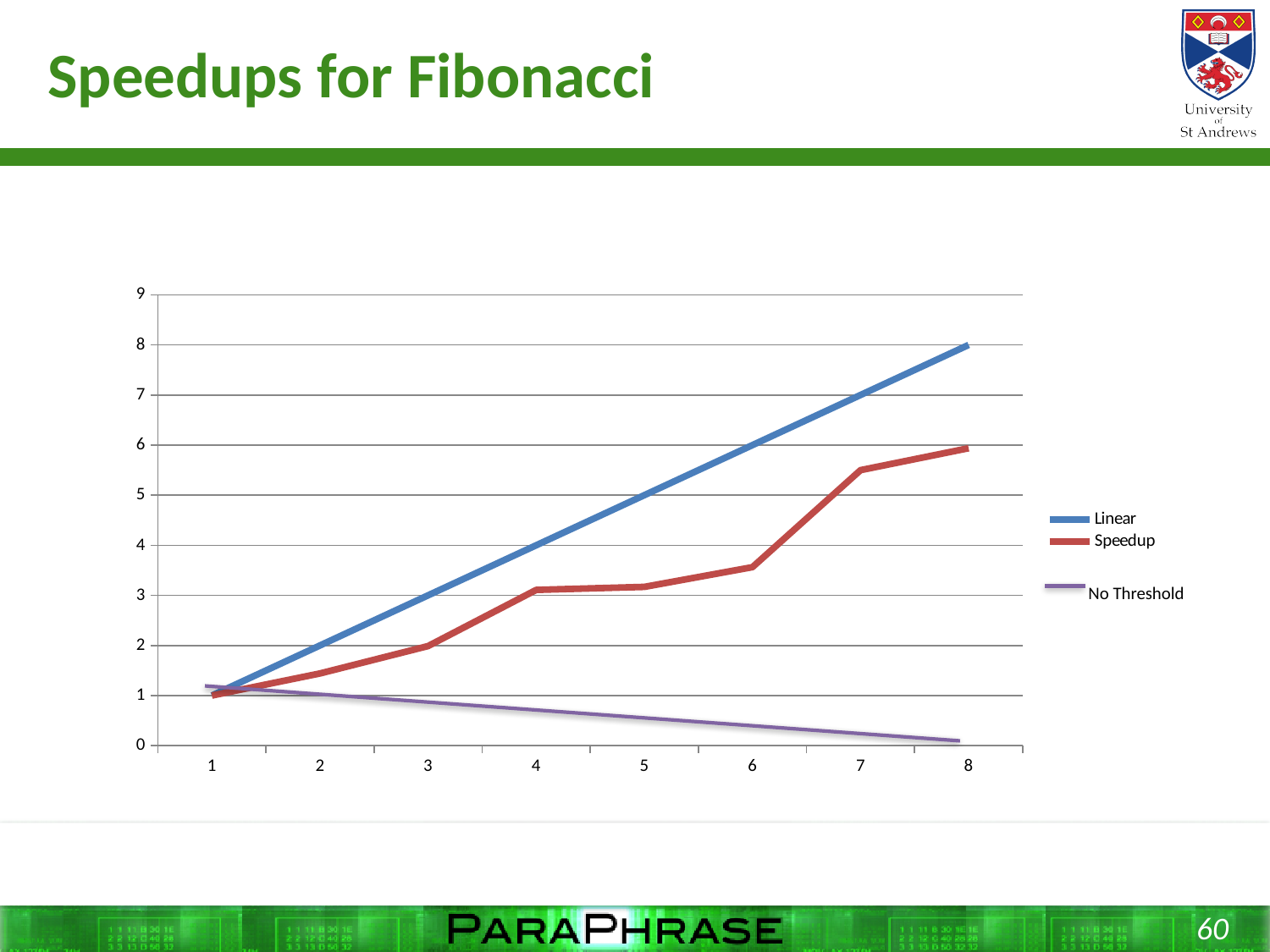
How many points are marked along the x axis? 8 What colour is the Speedup line in the legend? red What is the value of the Linear series at x = 8? 8 What is the value of the Linear series at x = 4? 4 How many series does the legend list? 3 What kind of chart is shown on the slide? line chart Which series has the lowest value at x = 8? No Threshold Which series has the highest value at x = 8? Linear Does the No Threshold series rise or fall as x increases from 1 to 8? fall Is the value of the Speedup series at x = 8 greater or less than 5? greater Is the value of the Speedup series at x = 6 greater or less than 4? less Does the Linear series rise or fall as x increases from 1 to 8? rise